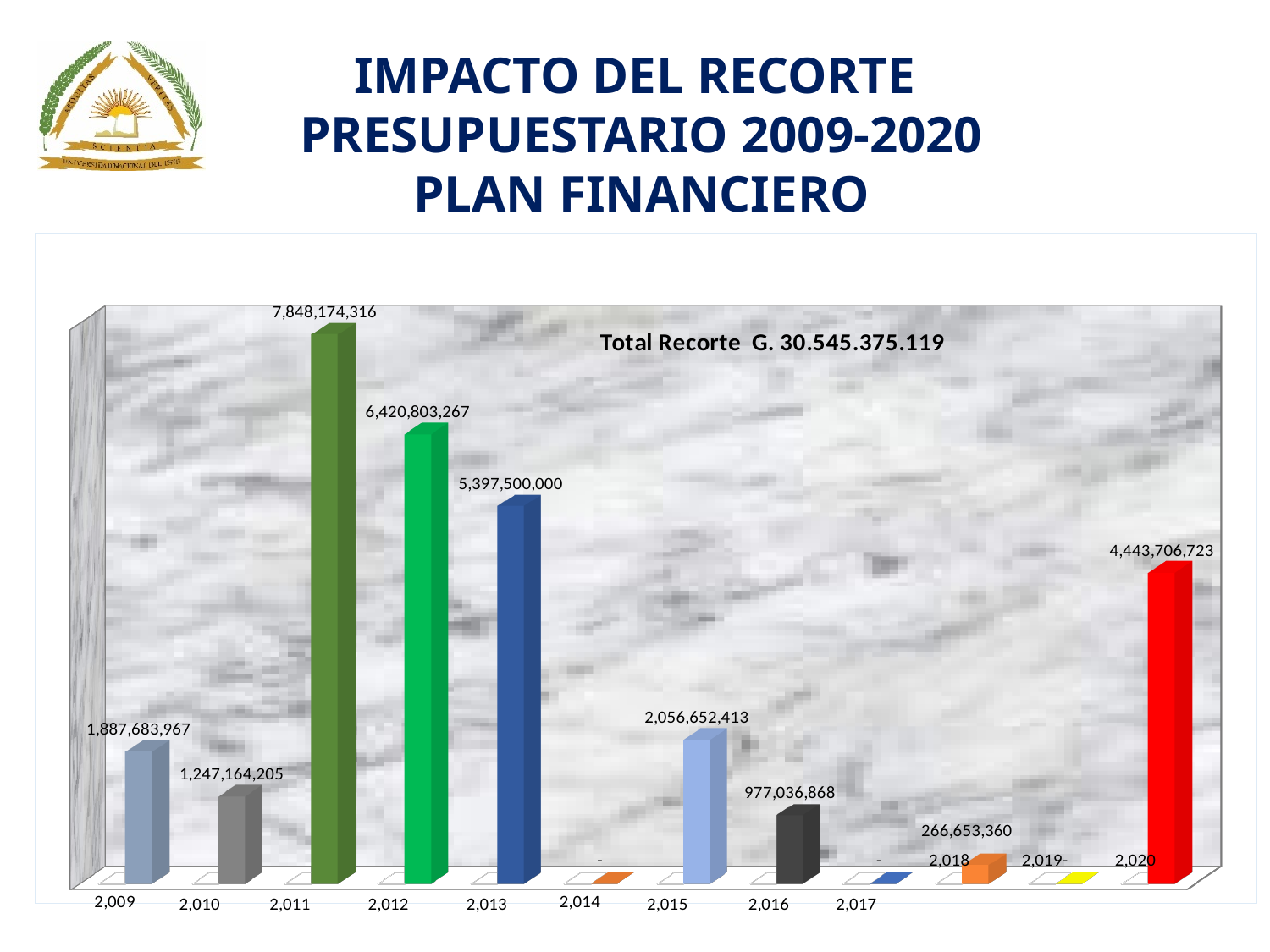
What kind of chart is shown on the slide? Bar chart Which year has the highest value in the chart? 2,011 Which is larger, the value for 2,009 or the value for 2,015? 2,015 How many years are shown on the x axis of the chart? 12 What is the value shown for 2,020? 4,443,706,723 What is the value shown for 2,011? 7,848,174,316 What colour is the bar for 2,020? Red What is the value shown for 2,016? 977,036,868 What is the value shown for 2,018? 266,653,360 Among the years with a non-zero bar, which year has the lowest value? 2,018 What total is stated in the text annotation inside the chart? G. 30.545.375.119 What is the difference between the values for 2,011 and 2,012? 1,427,371,049